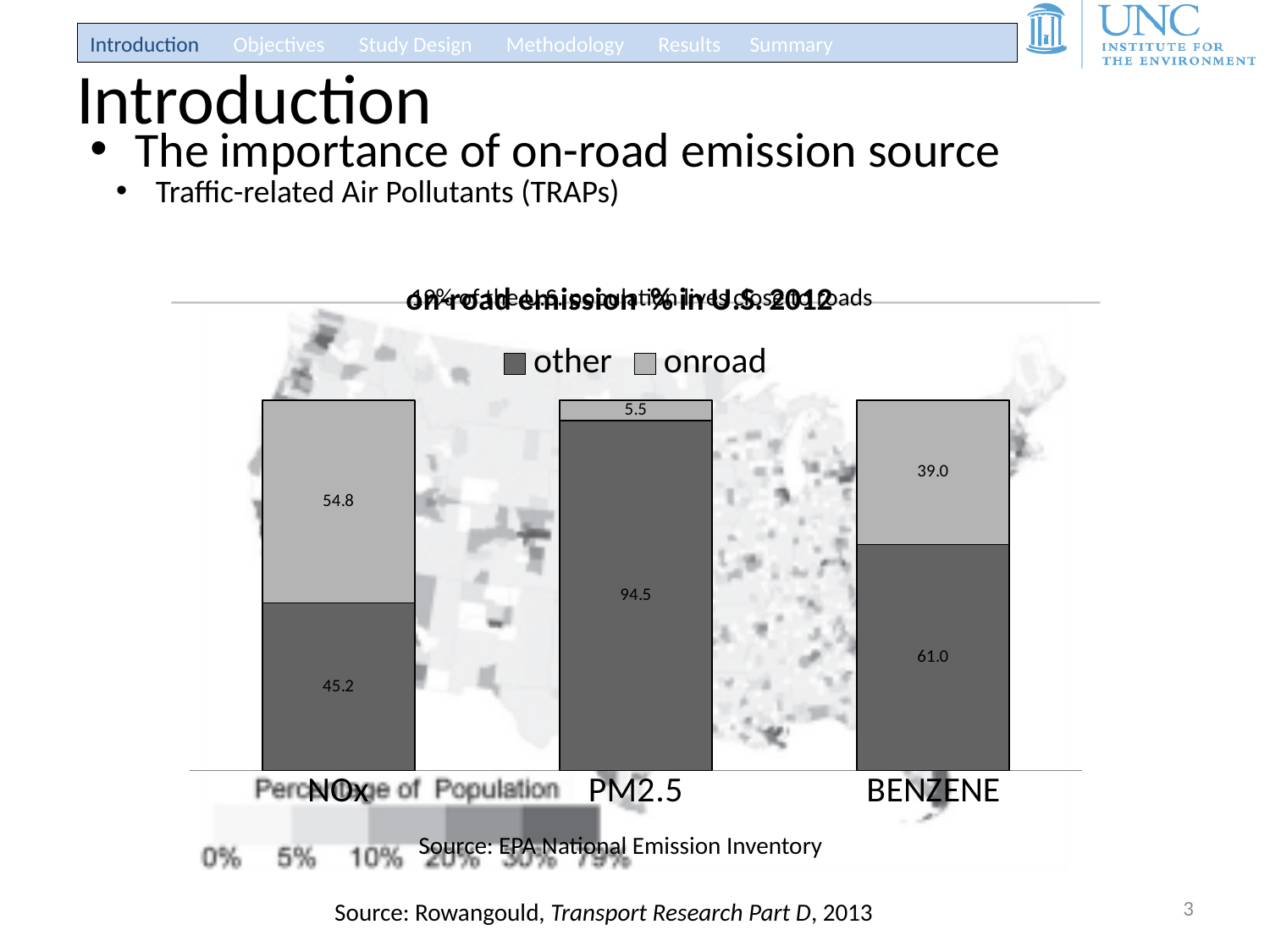
How many categories are shown on the x axis? 3 What is the other value for PM2.5? 94.5 What is the onroad value for NOx? 54.8 What is the difference between the other and onroad values for BENZENE? 22.0 What is the total of the stacked bar for PM2.5? 100.0 How many series does the legend list? 2 What is the onroad value for BENZENE? 39.0 What is the other value for NOx? 45.2 Which is larger for NOx, the other value or the onroad value? onroad What kind of chart is shown? stacked bar chart Which category has the lowest onroad value? PM2.5 Which category has the highest onroad value? NOx